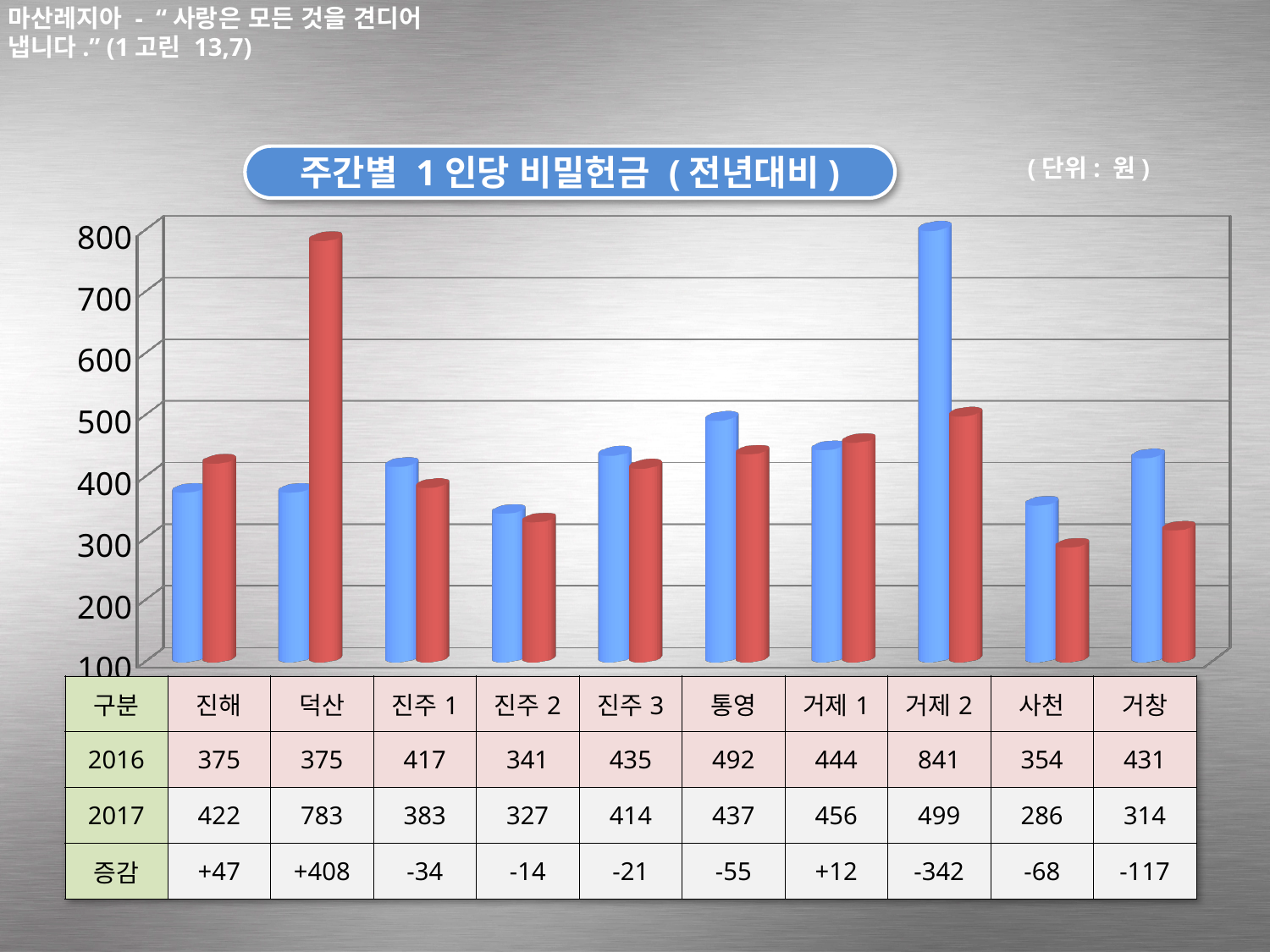
Which category has the highest 2017 value? 덕산 Which category has the highest 2016 value? 거제 2 What unit is stated for the values in the chart? 원 For 진해, which is larger: the 2016 value or the 2017 value? 2017 How many categories are shown on the x axis of the chart? 10 What is the 2017 value for 사천? 286 What is the 2017 value for 덕산? 783 What is the 2016 value for 거제 2? 841 Which category has the lowest 2017 value? 사천 What kind of chart is shown on the slide? bar chart Is the 2016 value for 거제 2 greater or less than 800? greater What is the difference between the 2017 and 2016 values for 덕산? 408